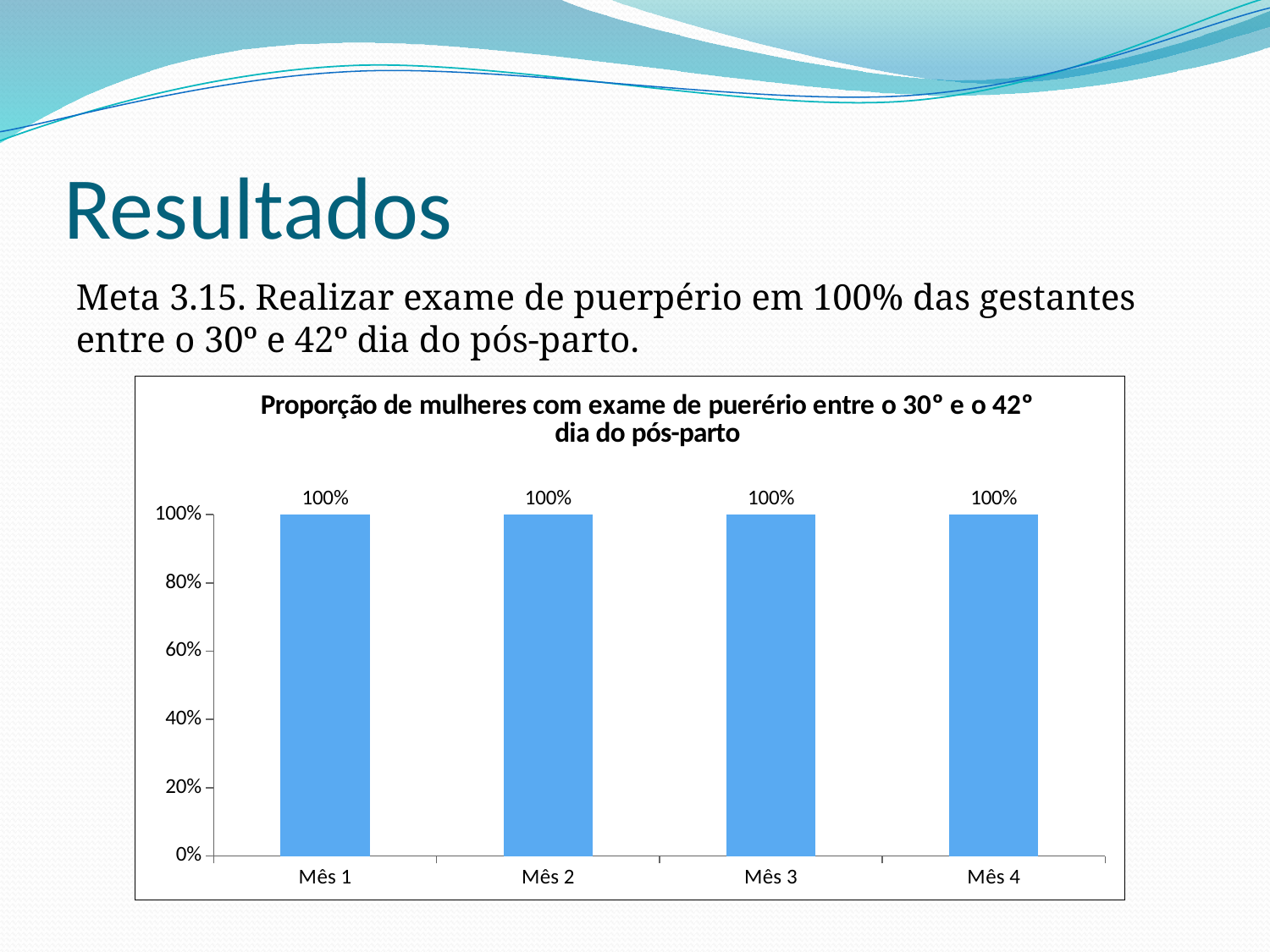
What kind of chart is shown on the slide? bar chart What is the highest value shown on the y axis? 100% What is the value for Mês 1? 100% What is the difference between the values for Mês 2 and Mês 4? 0% Is the value for Mês 2 greater or less than 80%? greater What is the title of the chart? Proporção de mulheres com exame de puerério entre o 30° e o 42° dia do pós-parto How many categories are shown on the x axis? 4 What is the value for Mês 4? 100% Do the values rise, fall or stay the same from Mês 1 to Mês 4? stay the same What colour are the bars in the chart? blue What is the value for Mês 3? 100%